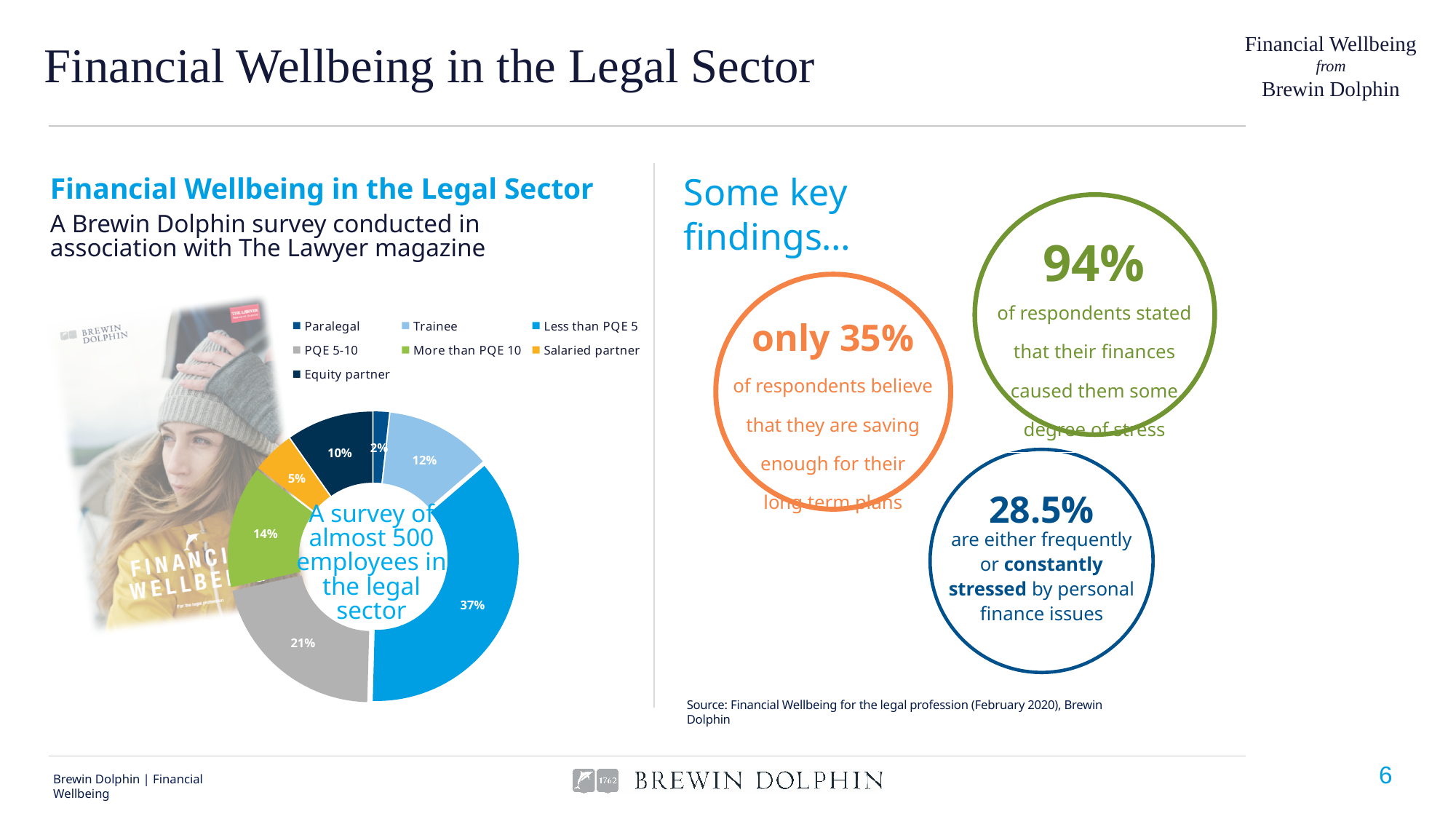
What is the combined percentage of the Trainee and Paralegal slices? 14% What share of the doughnut chart is labelled for Less than PQE 5? 37% Which slice is larger in the doughnut chart, More than PQE 10 or Equity partner? More than PQE 10 What percentage does the PQE 5-10 slice show in the doughnut chart? 21% What is the difference in percentage points between the Less than PQE 5 slice and the PQE 5-10 slice? 16 Which category has the smallest slice in the doughnut chart? Paralegal How many categories does the doughnut chart's legend list? 7 Which category has the largest slice in the doughnut chart? Less than PQE 5 What text appears in the centre of the doughnut chart? A survey of almost 500 employees in the legal sector What type of chart is shown on the slide? Doughnut (pie) chart What percentage is shown for Trainee in the doughnut chart? 12% What percentage is shown for Salaried partner in the doughnut chart? 5%